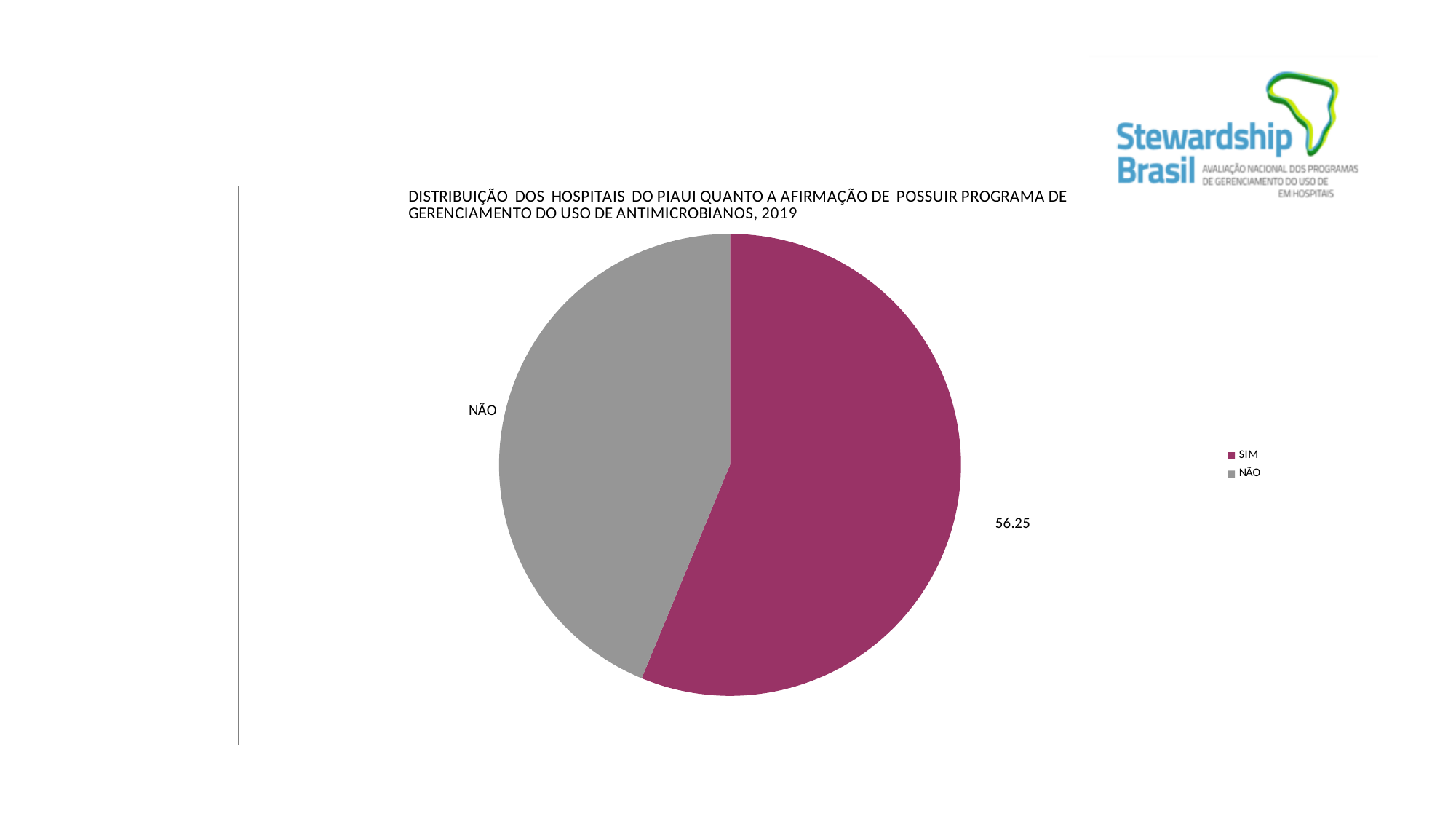
Which year is mentioned in the title of the pie chart? 2019 Which slice is larger in the pie chart, SIM or NÃO? SIM Which slice of the pie chart is the largest? SIM How many entries does the legend of the pie chart list? 2 What colour is the NÃO slice of the pie chart? grey What value is printed for the SIM slice of the pie chart? 56.25 Which slice of the pie chart is the smallest? NÃO How many slices does the pie chart have? 2 What kind of chart is shown on the slide? pie chart